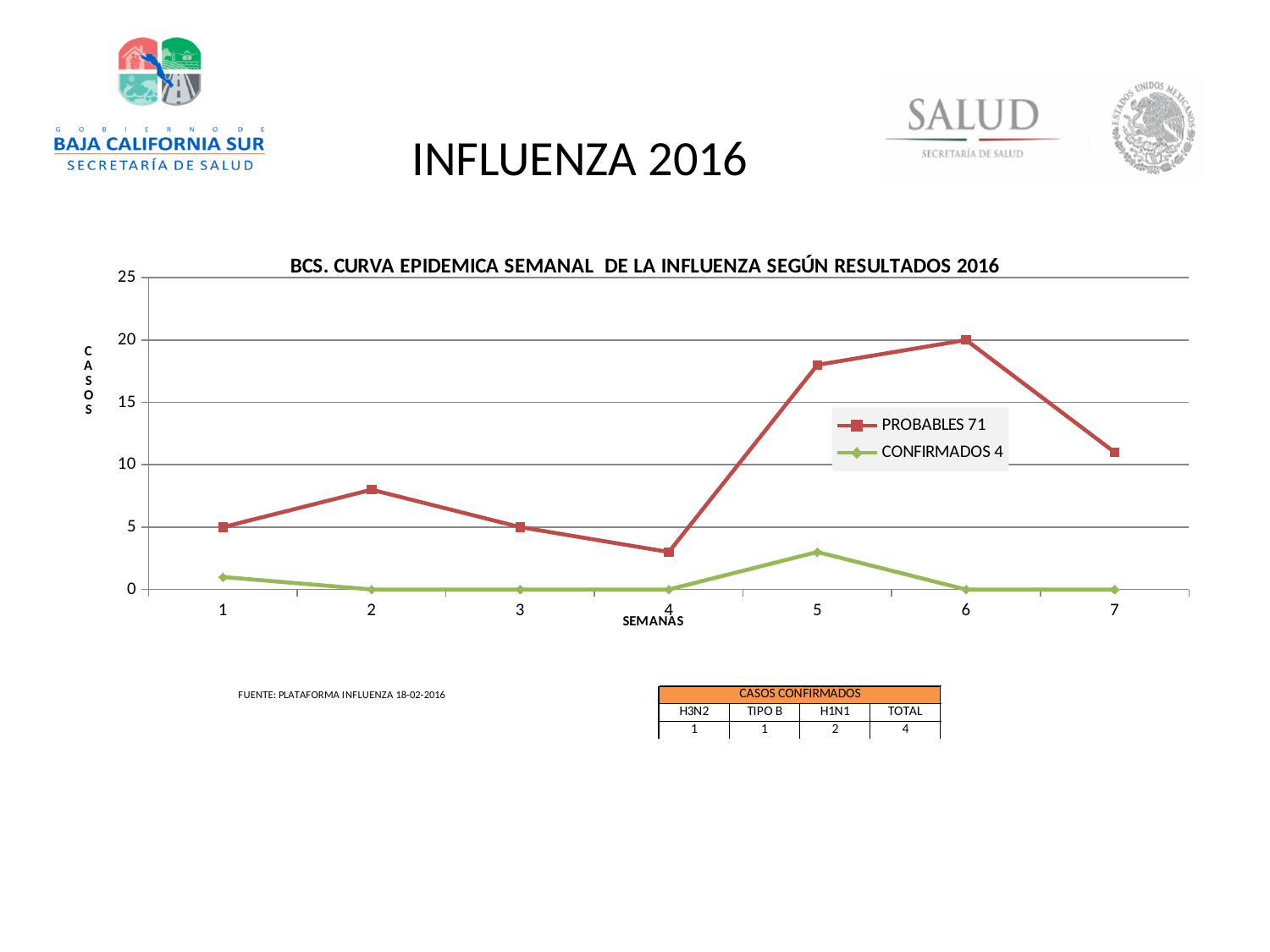
What kind of chart is shown on the slide? line chart In which week does the PROBABLES 71 series reach its highest value? 6 Does the PROBABLES 71 series rise or fall from week 6 to week 7? fall How many weeks (semanas) are plotted on the x axis? 7 How many series does the legend list? 2 Is the value for PROBABLES 71 in week 4 greater or less than 5? less In which week does the PROBABLES 71 series reach its lowest value? 4 Is the value for PROBABLES 71 in week 5 greater or less than 15? greater Which series has the larger value in week 5, PROBABLES 71 or CONFIRMADOS 4? PROBABLES 71 In which week does the CONFIRMADOS 4 series reach its highest value? 5 What is the value of CONFIRMADOS 4 in week 3? 0 What is the value of PROBABLES 71 in week 6? 20